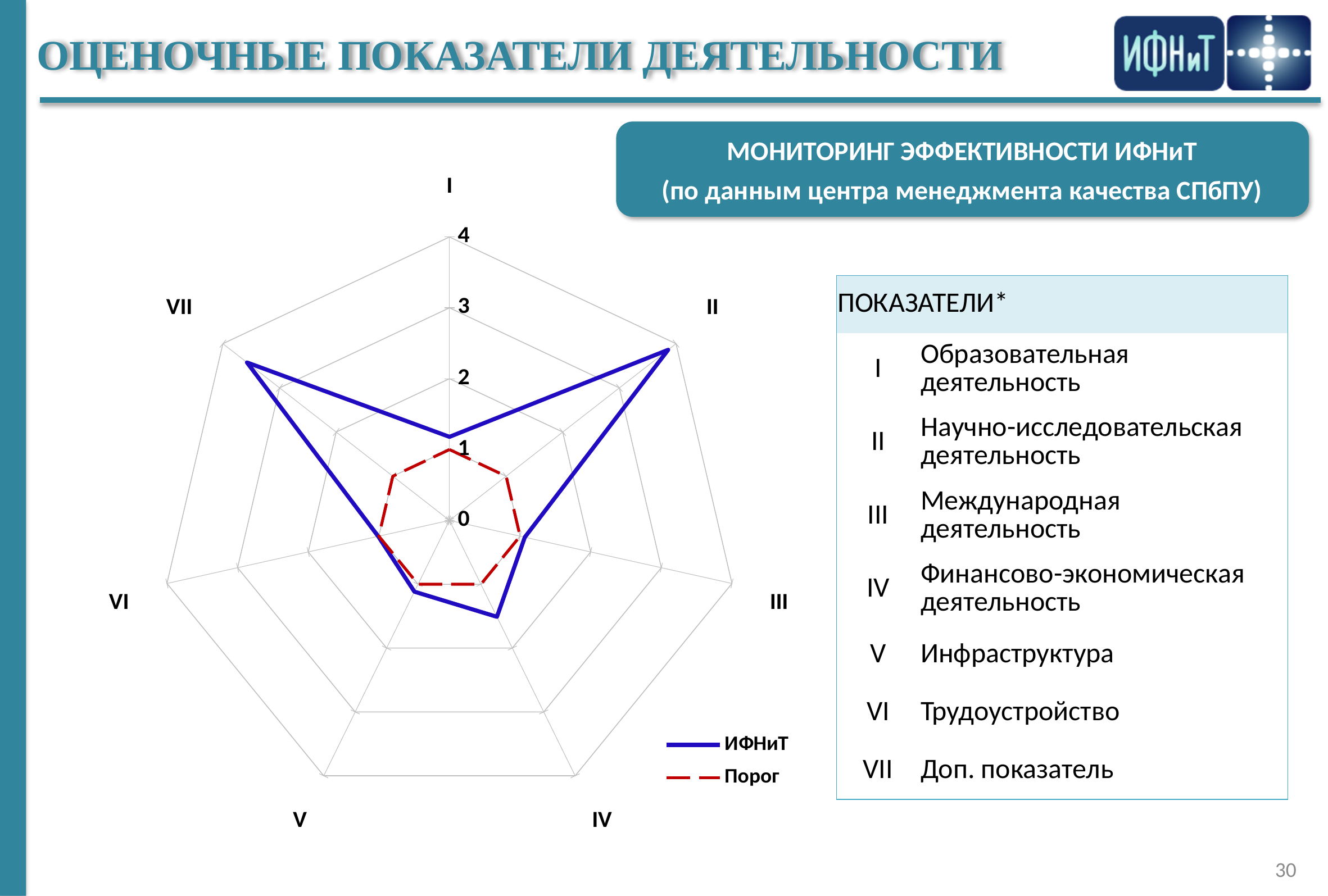
Is the ИФНиТ value on axis I greater or less than 2? less What value does the Порог (threshold) series have on axis I? 1 On which axis does the ИФНиТ series reach its highest value? II Is the ИФНиТ value on axis II greater or less than 3? greater Is the ИФНиТ value on axis IV greater or less than 2? less What are the two series named in the chart legend? ИФНиТ and Порог How many axes (categories) does the radar chart have? 7 How many series does the chart legend list? 2 Which is larger for the ИФНиТ series: the value on axis VII or the value on axis I? VII What kind of chart is shown on the slide? Radar chart What is the maximum value shown on the radar chart's scale? 4